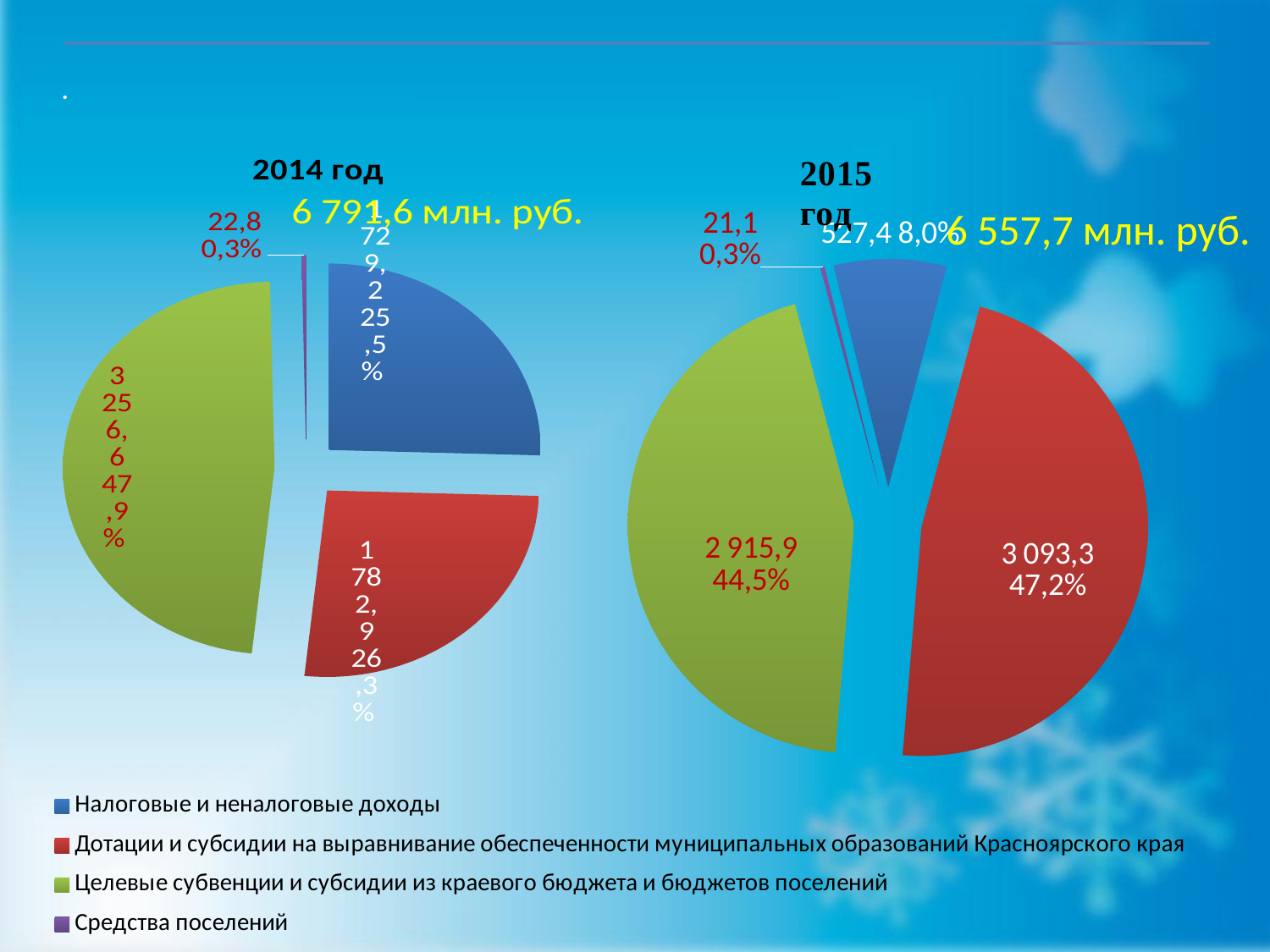
What total amount is shown next to the "2015 год" chart? 6 557,7 млн. руб. In the "2014 год" chart, what is the value for Средства поселений? 22,8 What kind of chart is the "2015 год" chart? pie chart How many entries does the legend list? 4 In the "2015 год" chart, which is larger: the slice for Дотации и субсидии на выравнивание обеспеченности муниципальных образований Красноярского края or the slice for Налоговые и неналоговые доходы? Дотации и субсидии на выравнивание обеспеченности муниципальных образований Красноярского края In the "2014 год" chart, what share of the pie is Целевые субвенции и субсидии из краевого бюджета и бюджетов поселений? 47,9% In the "2015 год" chart, what is the value for Дотации и субсидии на выравнивание обеспеченности муниципальных образований Красноярского края? 3 093,3 In the "2015 год" chart, what share of the pie is Средства поселений? 0,3% In the "2014 год" chart, which category has the smallest slice? Средства поселений In the "2015 год" chart, which category has the largest slice? Дотации и субсидии на выравнивание обеспеченности муниципальных образований Красноярского края In the "2015 год" chart, what is the value for Налоговые и неналоговые доходы? 527,4 In the "2015 год" chart, what share of the pie is Целевые субвенции и субсидии из краевого бюджета и бюджетов поселений? 44,5%